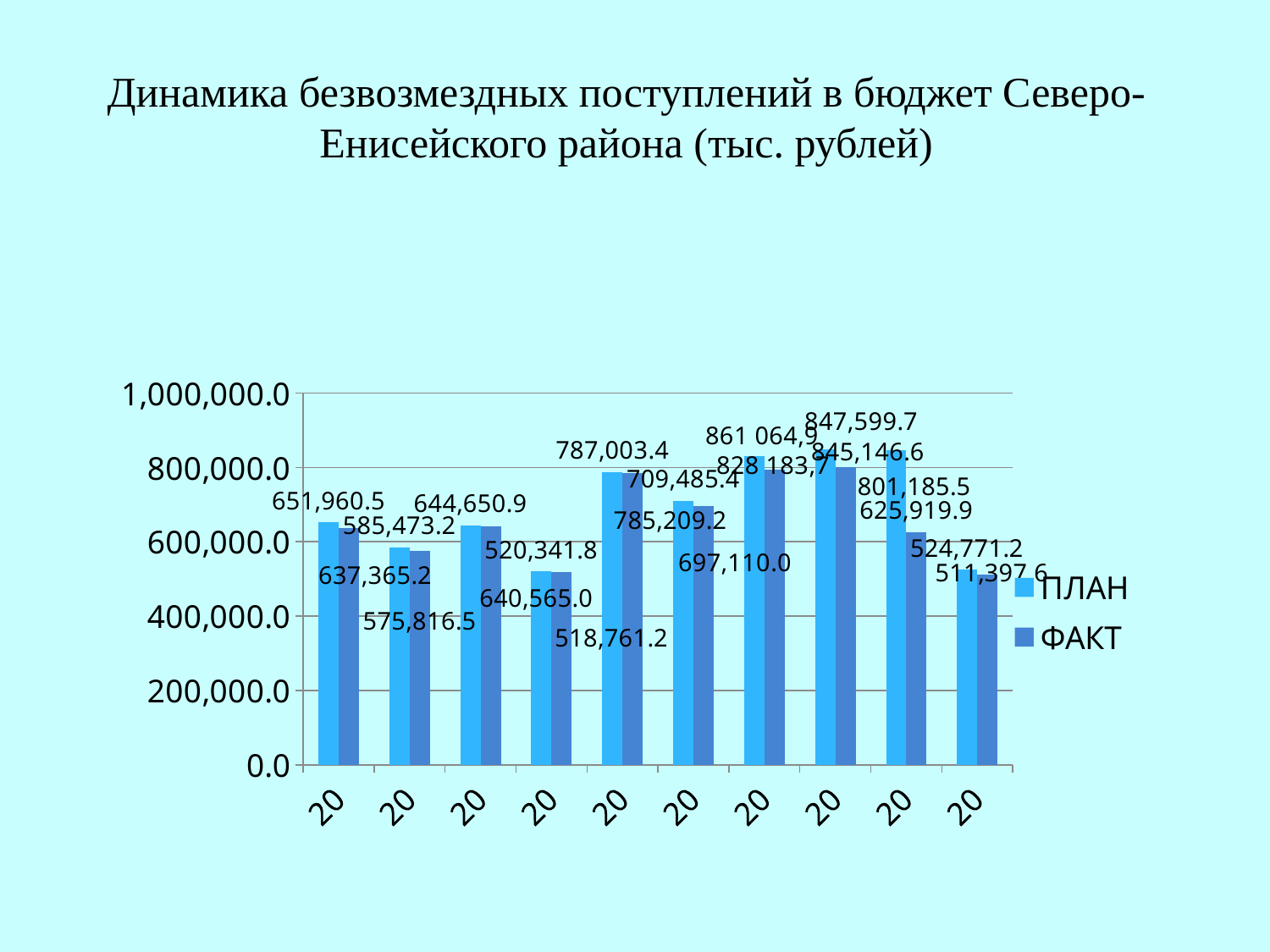
What are the two series named in the legend? ПЛАН and ФАКТ What is the difference between the ПЛАН and ФАКТ values in the ninth group of bars from the left? 219,226.7 What kind of chart is shown on the slide? bar chart How many series does the legend list? 2 How many groups of bars are plotted along the x axis? 10 Is the ПЛАН value for the fourth group of bars from the left greater or less than 600,000.0? less What is the ФАКТ value for the last (rightmost) group of bars? 511,397.6 What is the lowest ФАКТ value shown on the chart? 511,397.6 What is the ПЛАН value for the ninth group of bars from the left? 845,146.6 What is the ФАКТ value for the first (leftmost) group of bars? 637,365.2 What is the ПЛАН value for the first (leftmost) group of bars? 651,960.5